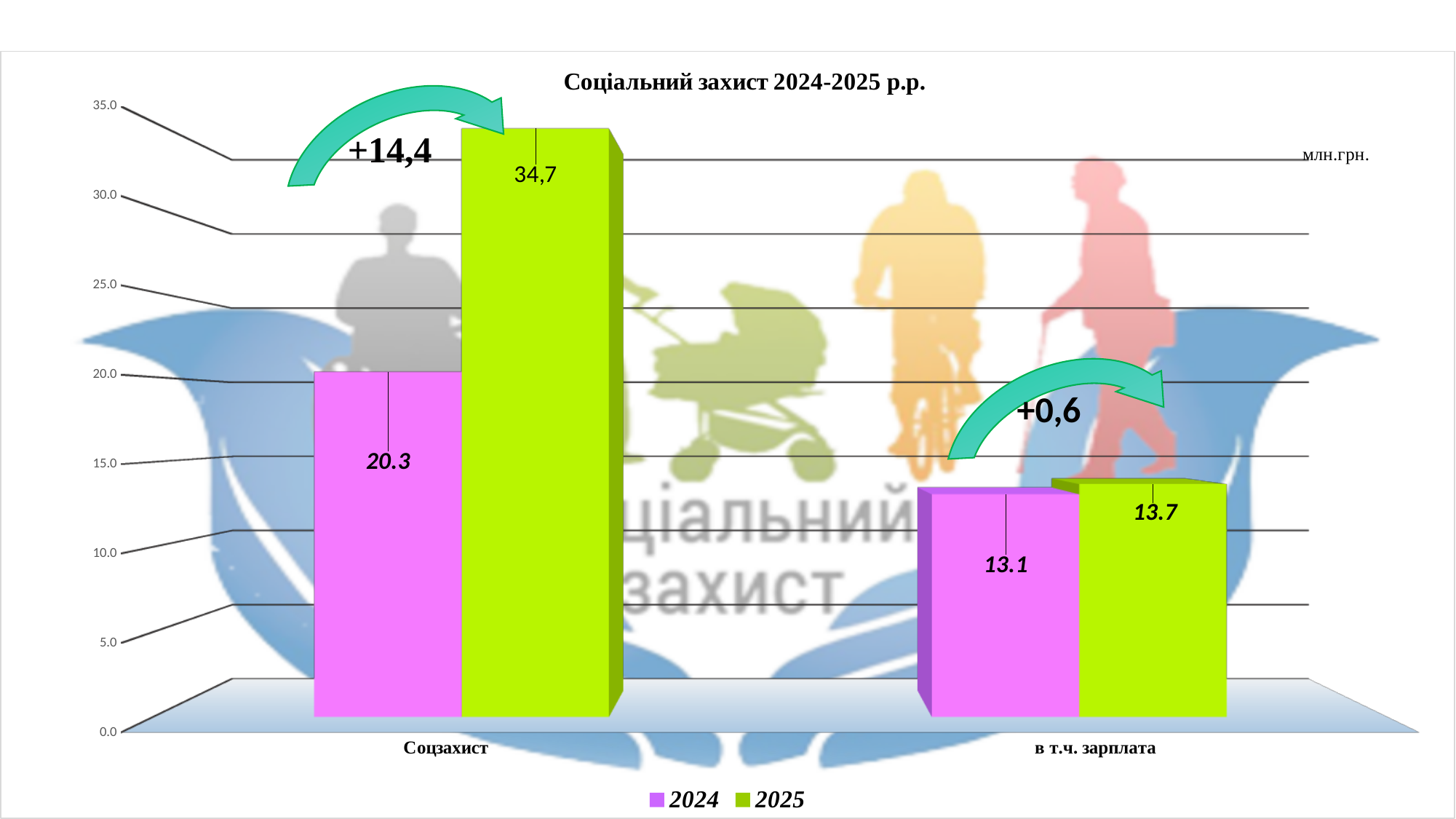
Which bar has the highest value on the chart? 2025, Соцзахист What is the difference between the 2025 and 2024 values for Соцзахист? 14.4 What is the value for 2025 in the Соцзахист category? 34,7 Which bar has the lowest value on the chart? 2024, в т.ч. зарплата What is the title of the chart? Соціальний захист 2024-2025 р.р. What is the value for 2025 in the в т.ч. зарплата category? 13.7 Which is larger for Соцзахист: the 2024 value or the 2025 value? 2025 How many categories are shown on the x axis? 2 Is the 2024 value for Соцзахист greater or less than 25.0? less How many series does the legend list? 2 What is the value for 2024 in the в т.ч. зарплата category? 13.1 What is the value for 2024 in the Соцзахист category? 20.3